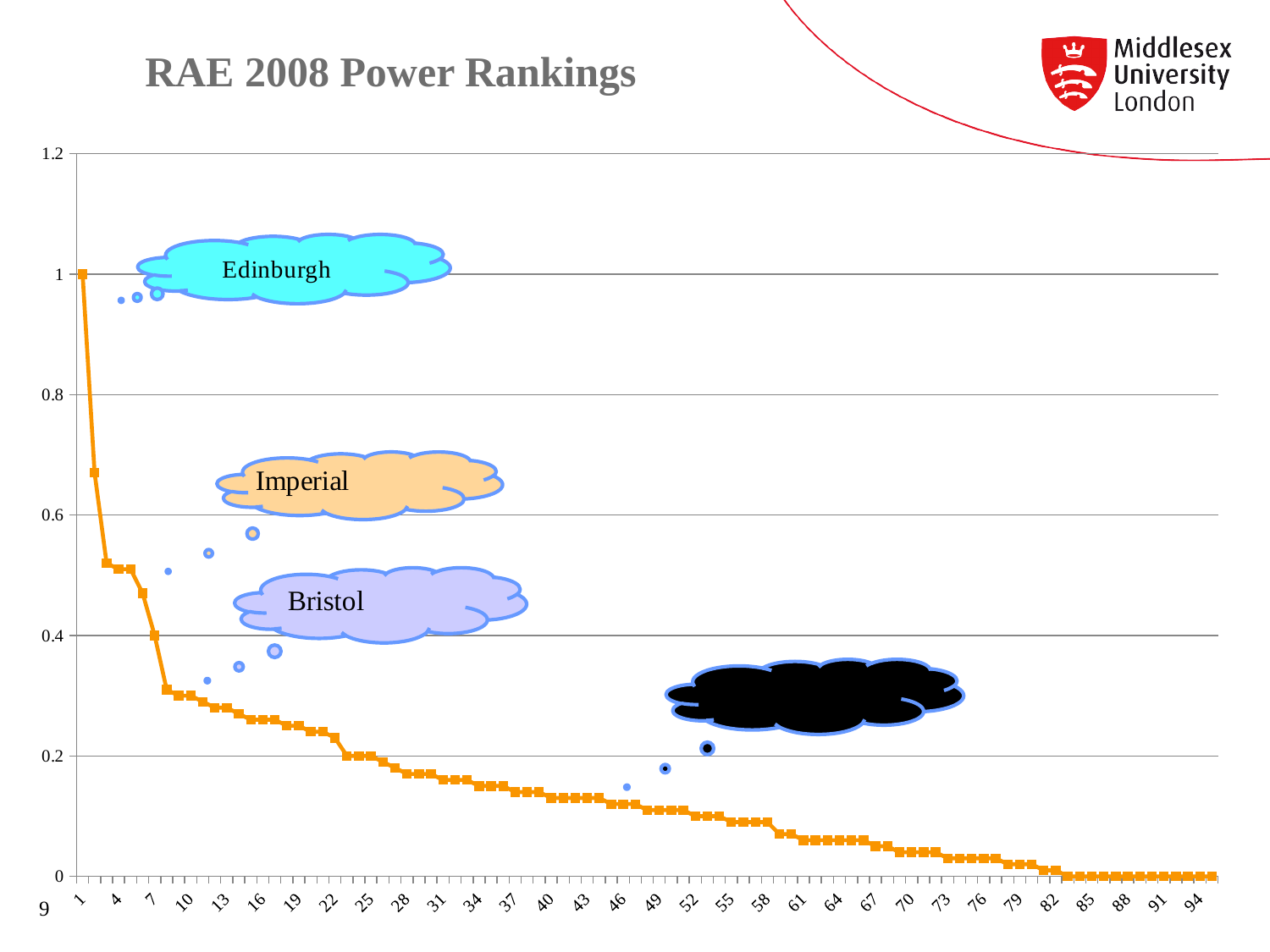
Is the value at rank 70 greater or less than 0.1? less What is the title of the chart? RAE 2008 Power Rankings What kind of chart is shown on the slide? line chart Is the value at rank 2 greater or less than 0.6? greater Is the value at rank 4 greater or less than 0.4? greater Which of the labelled callouts, Edinburgh or Bristol, points to the higher value? Edinburgh Which rank has the highest plotted value? 1 Do the plotted values rise or fall as the rank increases along the x axis? fall What is the plotted value at rank 1? 1 What is the highest value shown on the y axis? 1.2